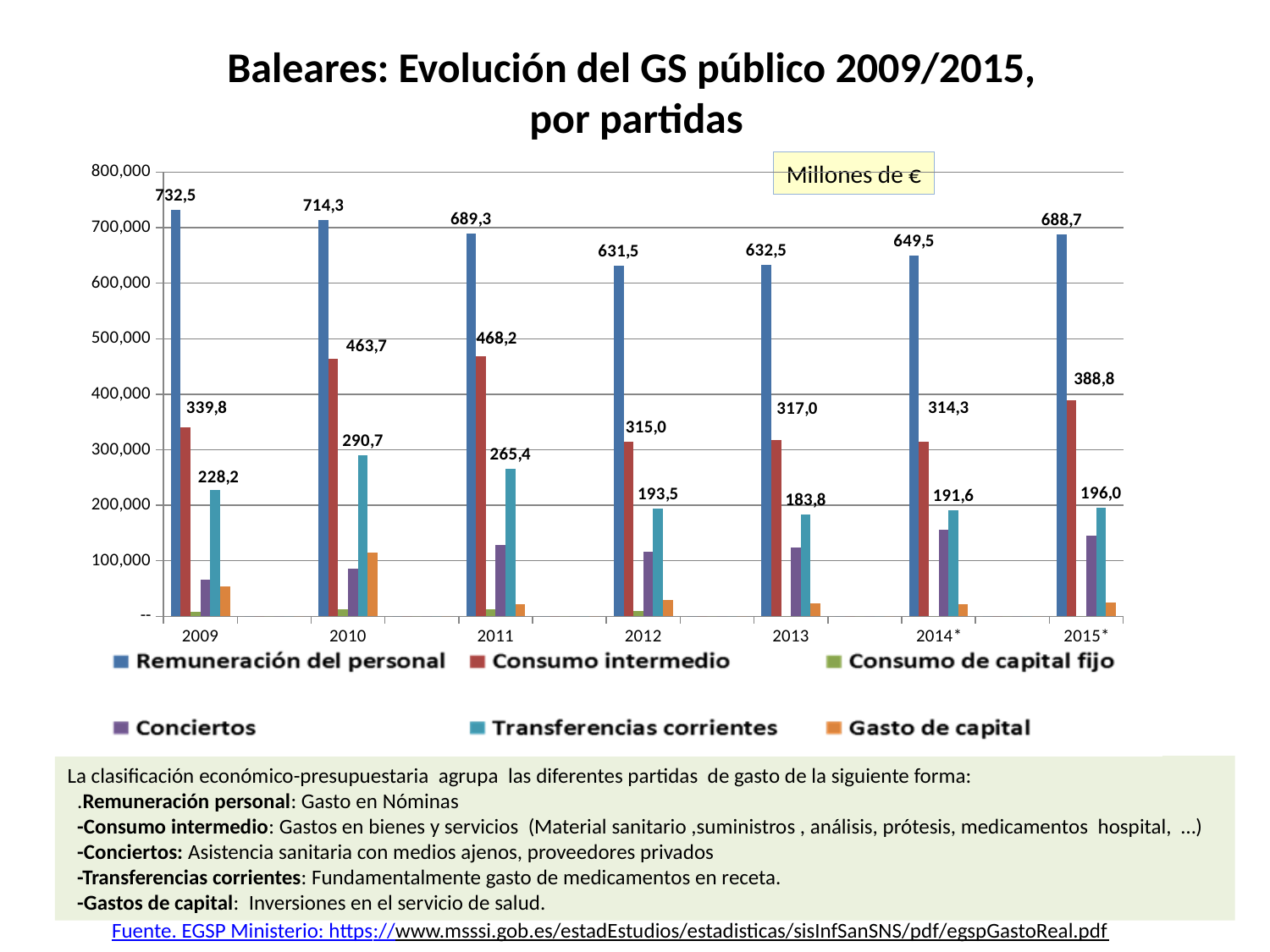
Is the value for Conciertos in 2014* greater or less than 100,000? greater What is the labelled value for Consumo intermedio in 2011? 468,2 How many series does the legend list? 6 What is the labelled value for Remuneración del personal in 2009? 732,5 How many years are shown on the x axis? 7 What is the difference between the Remuneración del personal values for 2009 and 2015*? 43,8 What type of chart is shown on the slide? bar chart What unit is indicated in the box at the top of the chart? Millones de € Which is larger, Transferencias corrientes in 2010 or in 2011? 2010 In which year is Remuneración del personal lowest? 2012 In which year is Consumo intermedio highest? 2011 What is the labelled value for Transferencias corrientes in 2013? 183,8